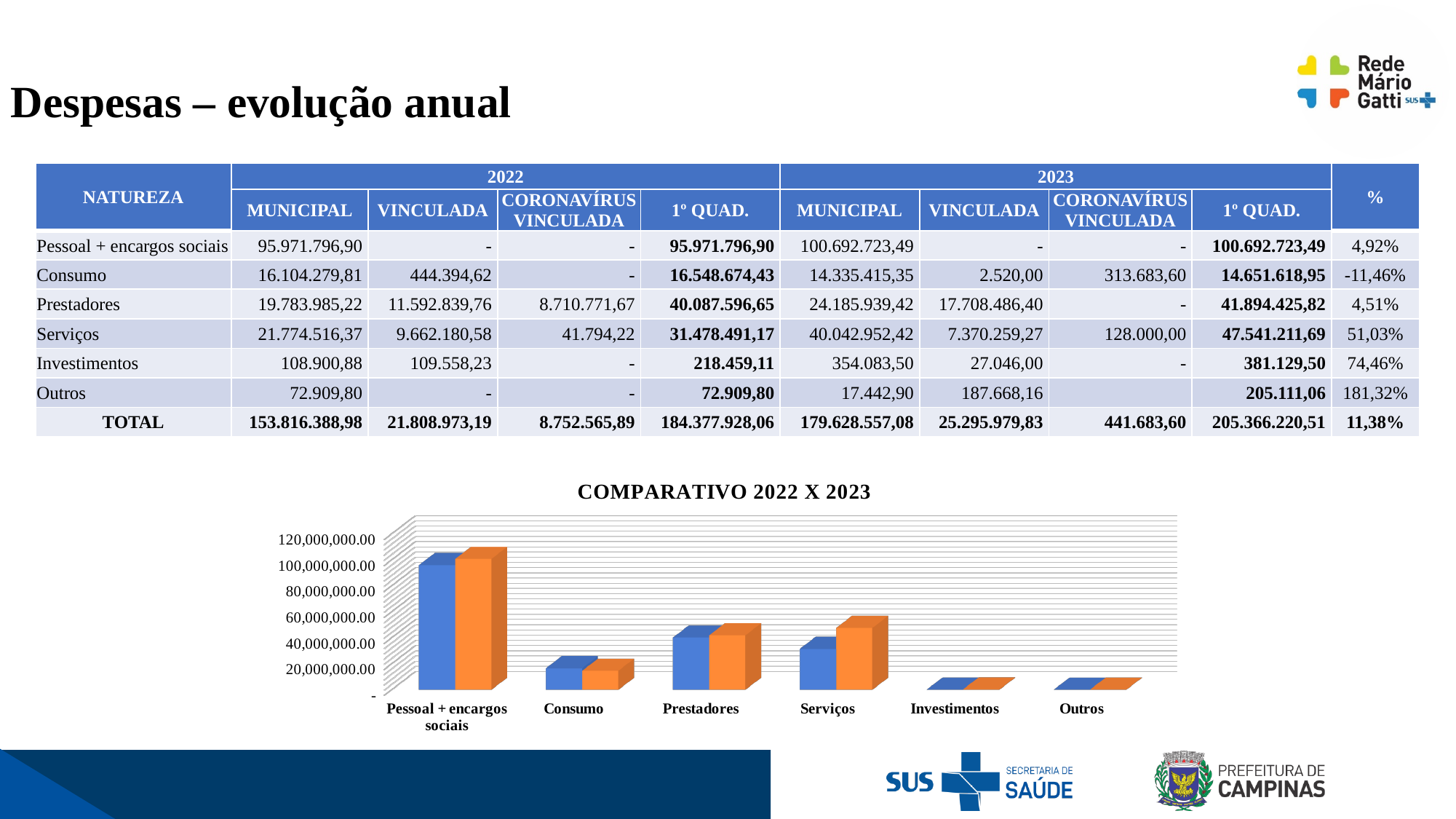
What is the title of the chart on the slide? COMPARATIVO 2022 X 2023 What kind of chart is shown under the table? bar chart How many categories are shown on the x axis of the chart? 6 In the chart, is the blue bar for Consumo greater or less than 20,000,000.00? less What colours are the two bar series in the chart? blue and orange In the chart, which has the taller blue bar: Prestadores or Serviços? Prestadores In the chart, is the orange bar for Serviços greater or less than 40,000,000.00? greater In the chart, is the blue bar for Serviços greater or less than 40,000,000.00? less Which category has the tallest bars in the chart? Pessoal + encargos sociais In the chart, which has the taller orange bar: Prestadores or Serviços? Serviços